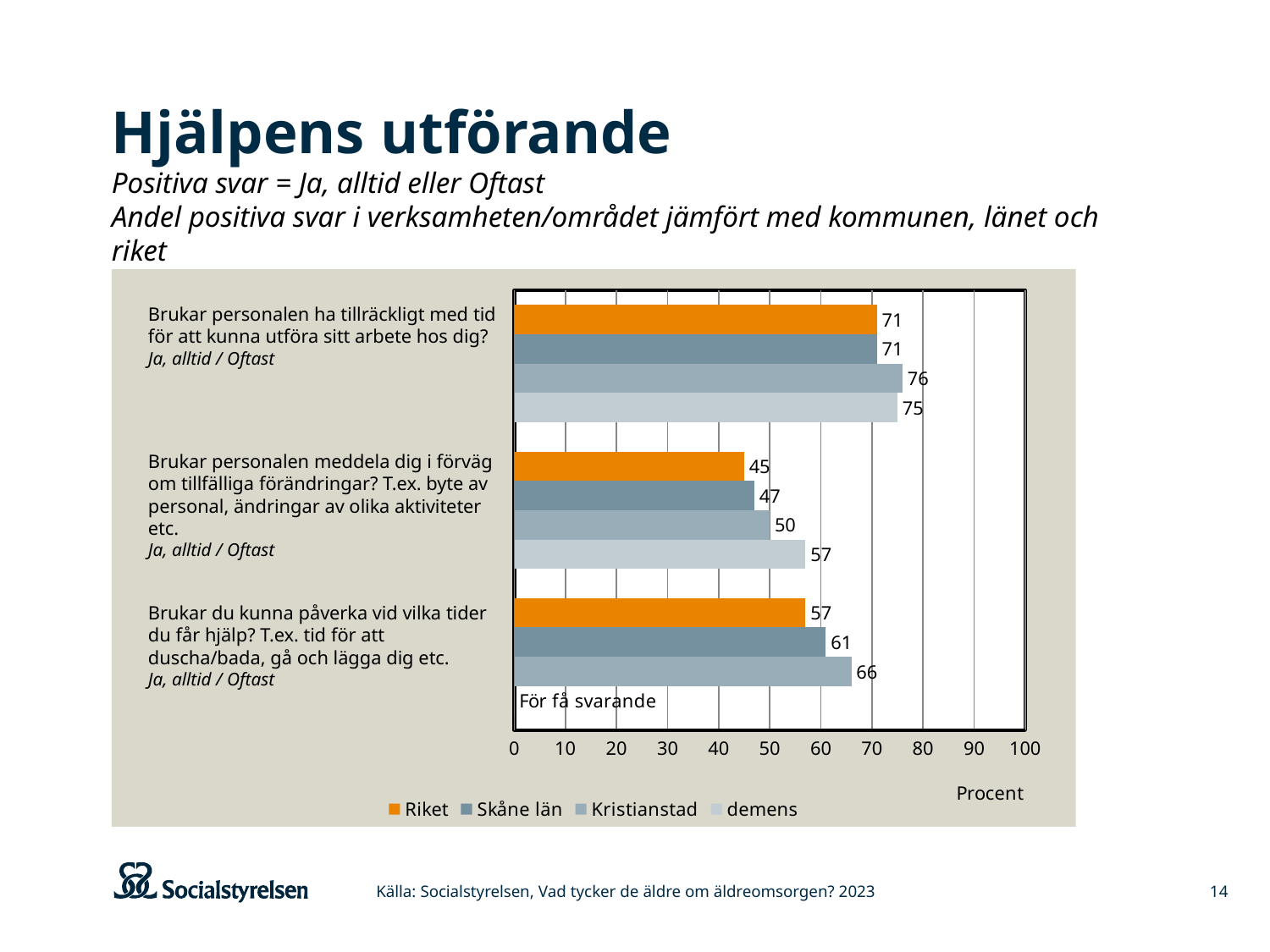
How many series does the legend list? 4 What is shown instead of a bar for demens on the question "Brukar du kunna påverka vid vilka tider du får hjälp?"? För få svarande How many question categories are shown on the chart? 3 What is the difference between Kristianstad and Riket on the question "Brukar du kunna påverka vid vilka tider du får hjälp?"? 9 What kind of chart is shown on the slide? Bar chart What is the value for Kristianstad on the question "Brukar personalen ha tillräckligt med tid för att kunna utföra sitt arbete hos dig?"? 76 Which series has the lowest value on the question "Brukar du kunna påverka vid vilka tider du får hjälp?" among those with a plotted value? Riket What is the value for Skåne län on the question "Brukar du kunna påverka vid vilka tider du får hjälp?"? 61 What is the value for demens on the question "Brukar personalen meddela dig i förväg om tillfälliga förändringar?"? 57 Which is larger on the question "Brukar personalen ha tillräckligt med tid för att kunna utföra sitt arbete hos dig?": Kristianstad or demens? Kristianstad Which series has the highest value on the question "Brukar personalen meddela dig i förväg om tillfälliga förändringar?"? demens What is the value for Riket on the question "Brukar personalen meddela dig i förväg om tillfälliga förändringar?"? 45